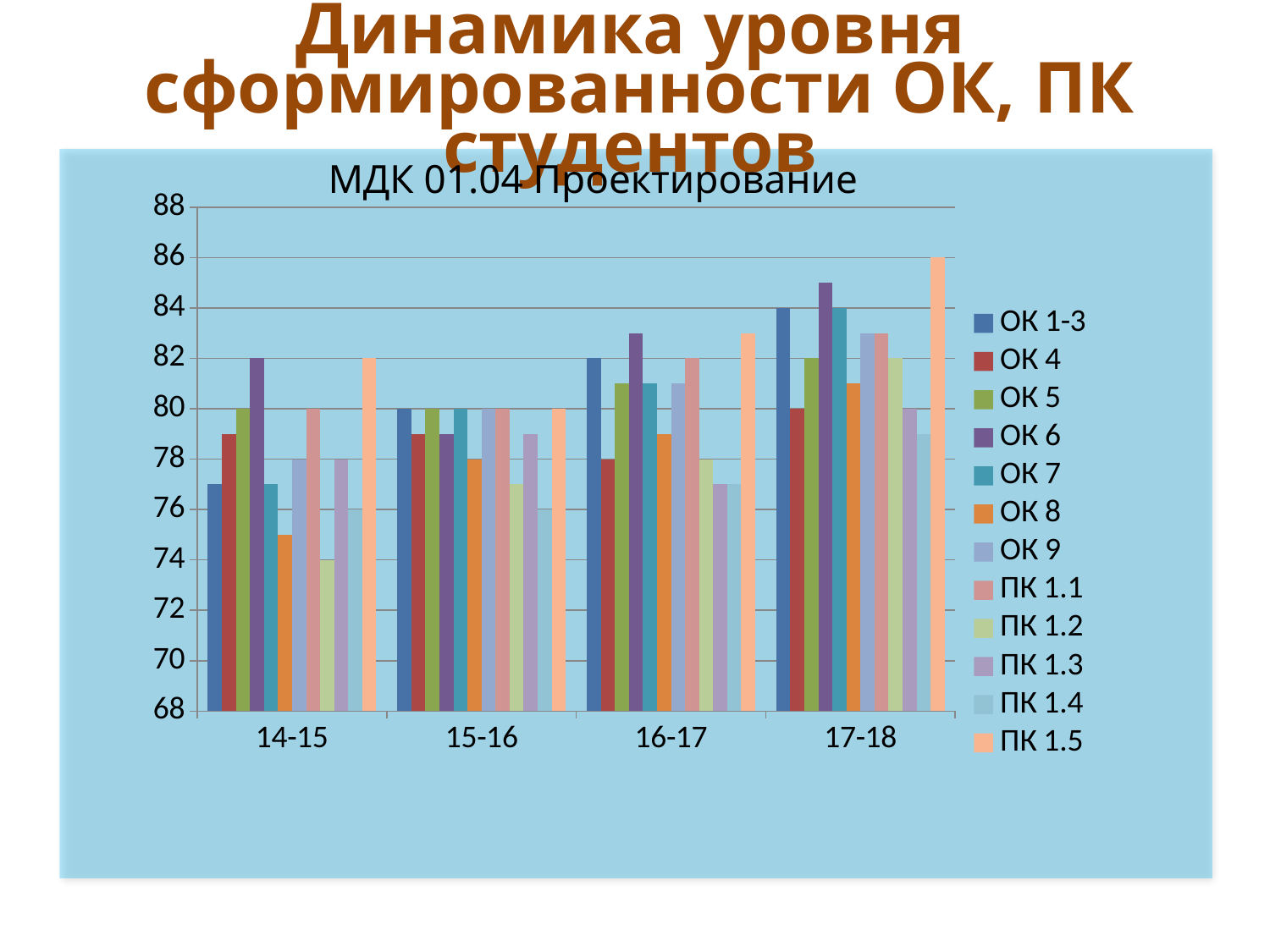
How many series does the legend list? 12 Which series has the highest value in 17-18? ПК 1.5 What is the title of the chart? МДК 01.04 Проектирование Does the value for ОК 1-3 rise or fall from 14-15 to 17-18? Rises What is the value for ОК 6 in 14-15? 82 Is the value for ОК 8 in 14-15 greater or less than 76? less Is the value for ОК 6 in 17-18 greater or less than 84? greater What is the value for ПК 1.2 in 14-15? 74 What kind of chart is shown on the slide? Bar chart What is the value for ПК 1.5 in 17-18? 86 How many categories are shown on the x axis? 4 Which series has the lowest value in 14-15? ПК 1.2